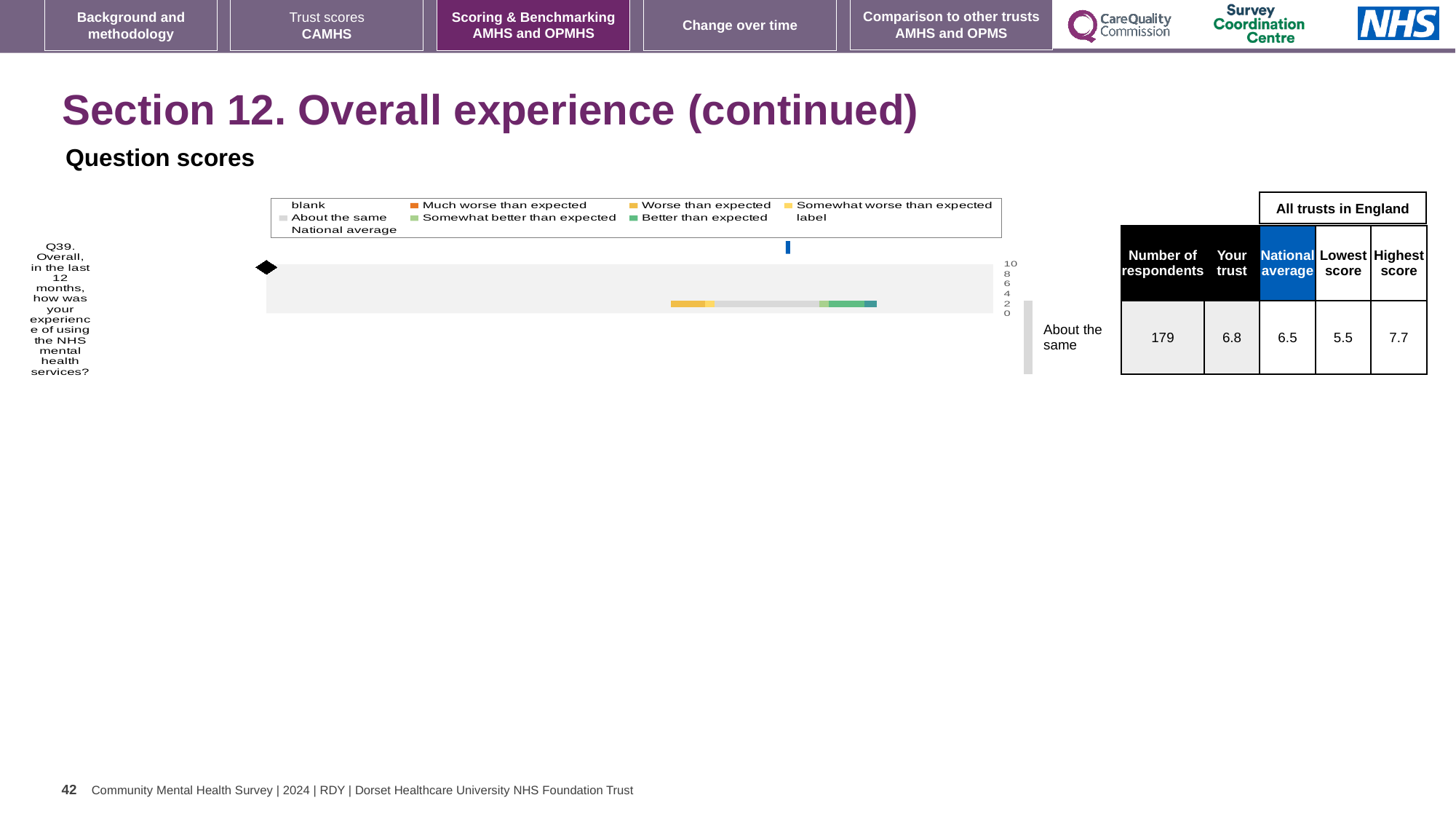
How many survey questions are plotted on the chart? 1 What is the highest score among all trusts in England for Q39? 7.7 How many respondents answered Q39? 179 What kind of chart is used to show the Q39 question score? bar chart What is the difference between the highest score and the lowest score for Q39? 2.2 What is the highest value shown on the chart's score axis? 10 Which benchmark category is the trust's Q39 score placed in? About the same What is the national average score for Q39? 6.5 Which is larger for Q39, the 'Your trust' score or the national average? Your trust What is the lowest score among all trusts in England for Q39? 5.5 By how much does the 'Your trust' score for Q39 exceed the national average? 0.3 What is the 'Your trust' score for Q39 (overall experience of using NHS mental health services)? 6.8